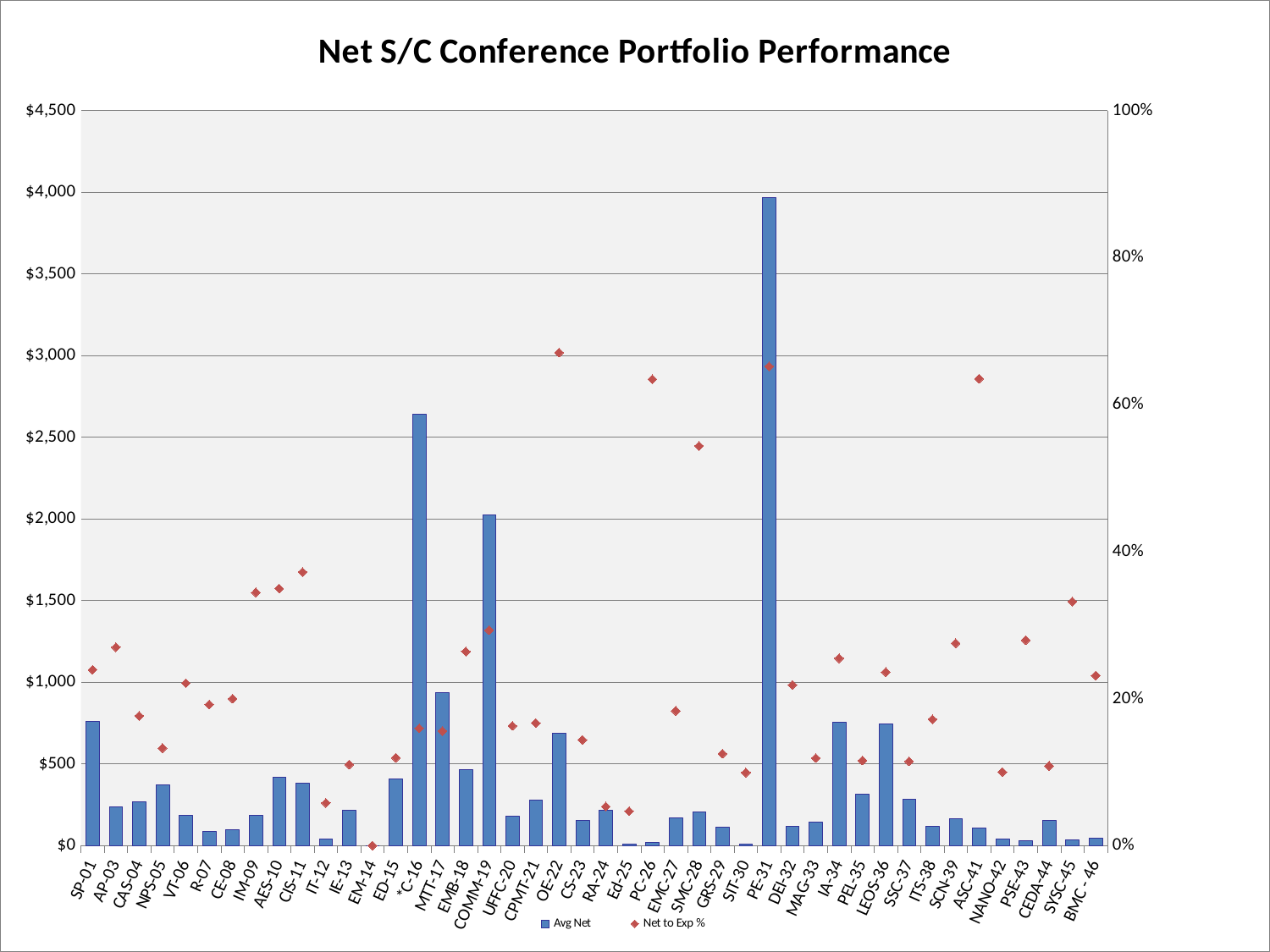
Is the Avg Net value for *C-16 greater or less than $2,500? greater How many series does the legend list? 2 What kind of chart is this? Combined bar and scatter chart Is the Avg Net value for COMM-19 greater or less than $2,500? less Is the Net to Exp % value for CIS-11 greater or less than 40%? less Which conference has the highest Net to Exp % marker? OE-22 What are the two series named in the legend? Avg Net and Net to Exp % Which conference has the highest Avg Net bar? PE-31 What is the title of the chart? Net S/C Conference Portfolio Performance Which has the larger Avg Net bar, *C-16 or COMM-19? *C-16 Which has the larger Avg Net bar, MTT-17 or SP-01? MTT-17